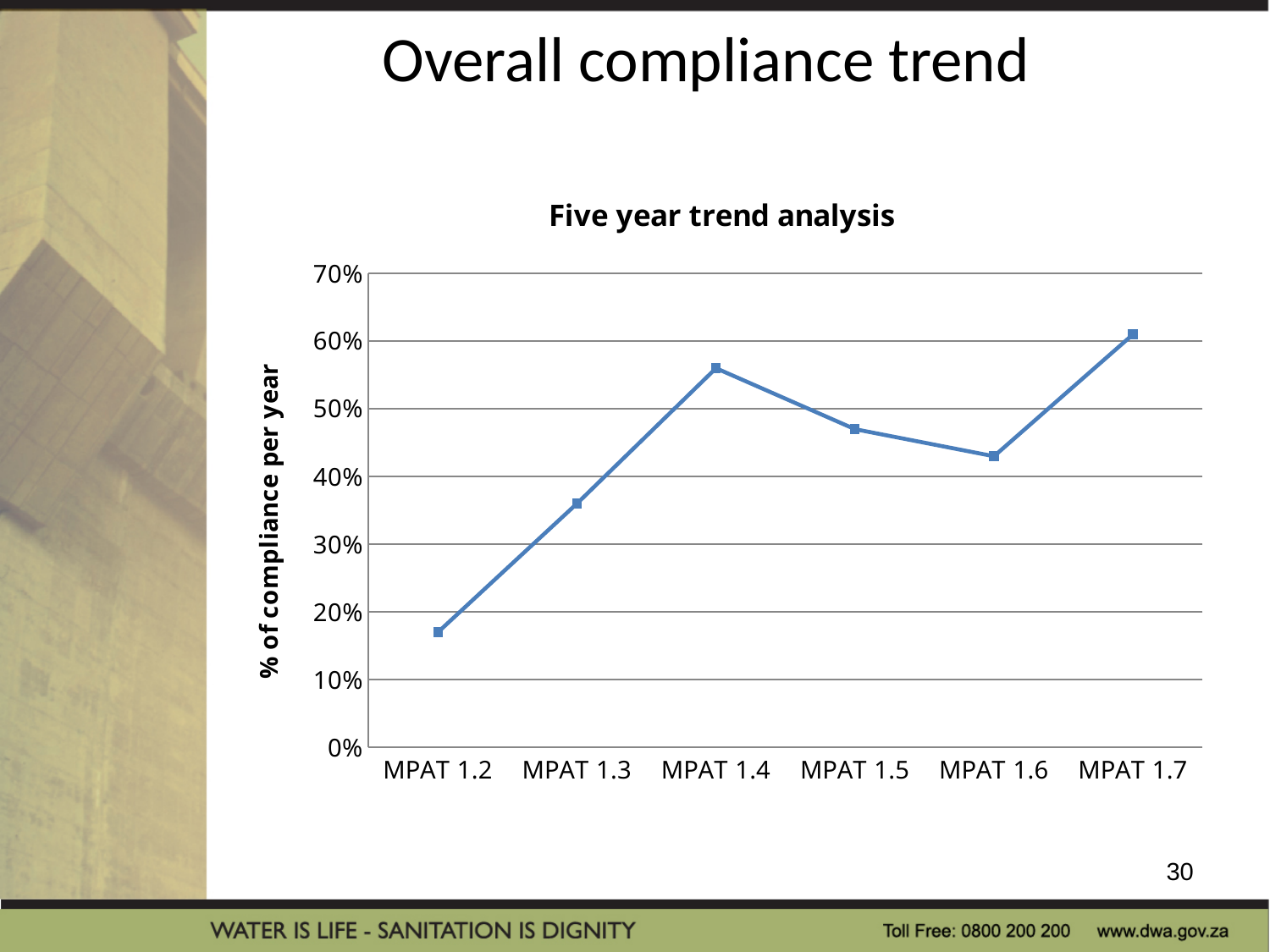
Is the value for MPAT 1.6 greater or less than 40%? greater Which is larger, the value for MPAT 1.4 or the value for MPAT 1.5? MPAT 1.4 Between MPAT 1.4 and MPAT 1.6, do the values rise or fall? fall What is the label on the vertical axis of the chart? % of compliance per year How many MPAT categories are plotted along the x axis? 6 Which MPAT category has the lowest compliance value? MPAT 1.2 What is the title of the chart? Five year trend analysis Is the value for MPAT 1.4 greater or less than 50%? greater Is the value for MPAT 1.2 greater or less than 20%? less Which MPAT category has the highest compliance value? MPAT 1.7 What kind of chart is shown on the slide? line chart